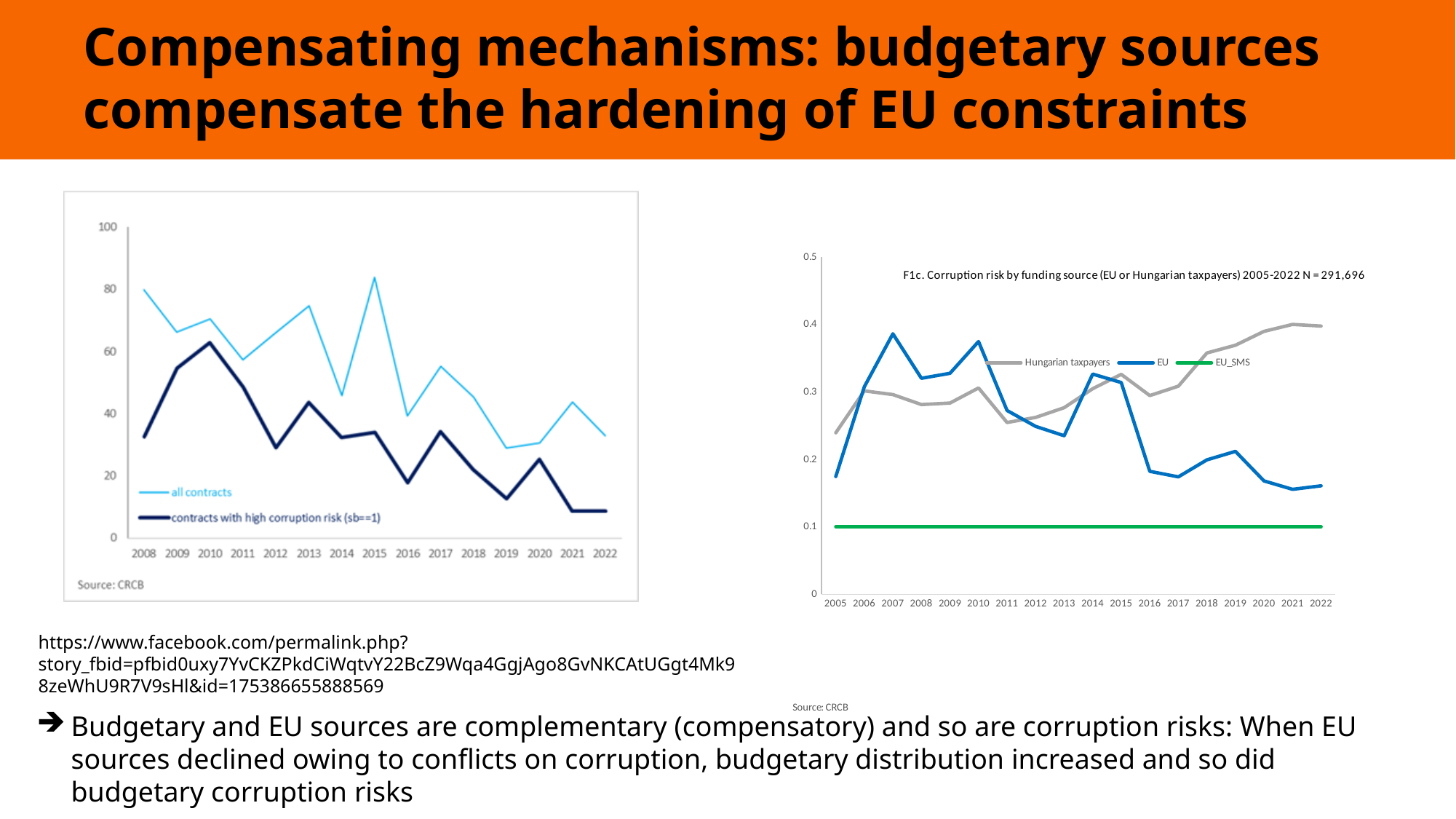
In the left chart, how many years are shown on the x axis? 15 In the right chart (F1c. Corruption risk by funding source), how many series does the legend list? 3 In the left chart, in which year is the value for contracts with high corruption risk highest? 2010 In the left chart, how many series does the legend list? 2 What kind of chart is the left chart (all contracts vs contracts with high corruption risk)? line chart In the right chart (F1c. Corruption risk by funding source), does the EU series rise or fall from 2015 to 2022? fall In the left chart, is the value for contracts with high corruption risk in 2022 greater or less than 20? less In the right chart (F1c. Corruption risk by funding source), how many years are shown on the x axis? 18 In the right chart (F1c. Corruption risk by funding source), which is larger in 2022, Hungarian taxpayers or EU? Hungarian taxpayers In the left chart, in which year is the value for all contracts highest? 2015 In the left chart, is the value for all contracts in 2008 greater or less than 60? greater In the right chart (F1c. Corruption risk by funding source), in which year is the value for Hungarian taxpayers lowest? 2005